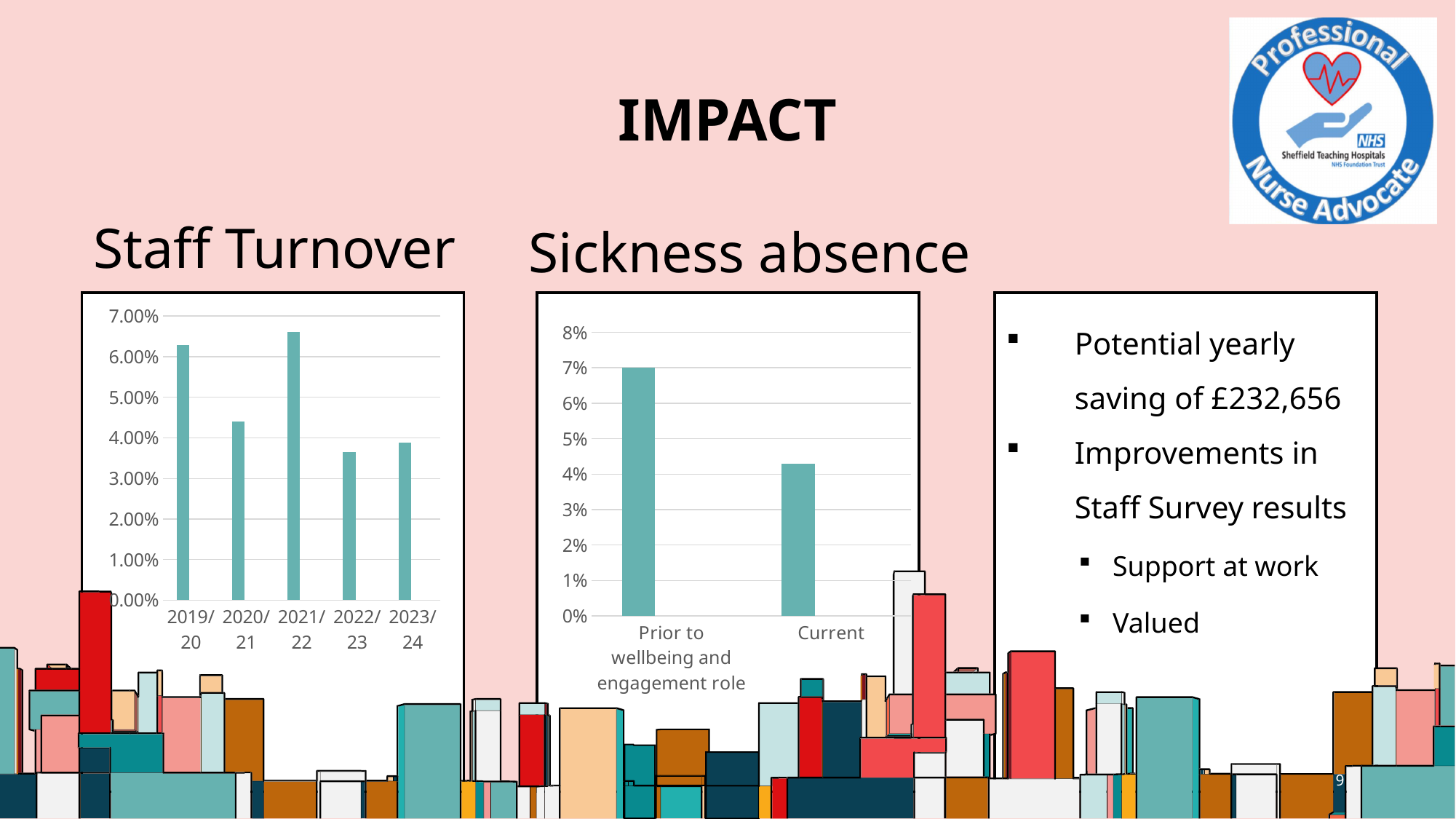
On the Sickness absence chart, is the value for Current greater or less than 5%? less On the Staff Turnover chart, which year has the highest turnover? 2021/22 On the Staff Turnover chart, is the value for 2019/20 greater or less than 6.00%? greater On the Sickness absence chart, is the value for Prior to wellbeing and engagement role greater or less than 6%? greater How many years are shown on the Staff Turnover chart? 5 What kind of chart is the Sickness absence chart? bar chart How many categories are shown on the Sickness absence chart? 2 What kind of chart is the Staff Turnover chart? bar chart On the Staff Turnover chart, which is larger, the value for 2019/20 or the value for 2020/21? 2019/20 On the Sickness absence chart, which category has the higher value? Prior to wellbeing and engagement role